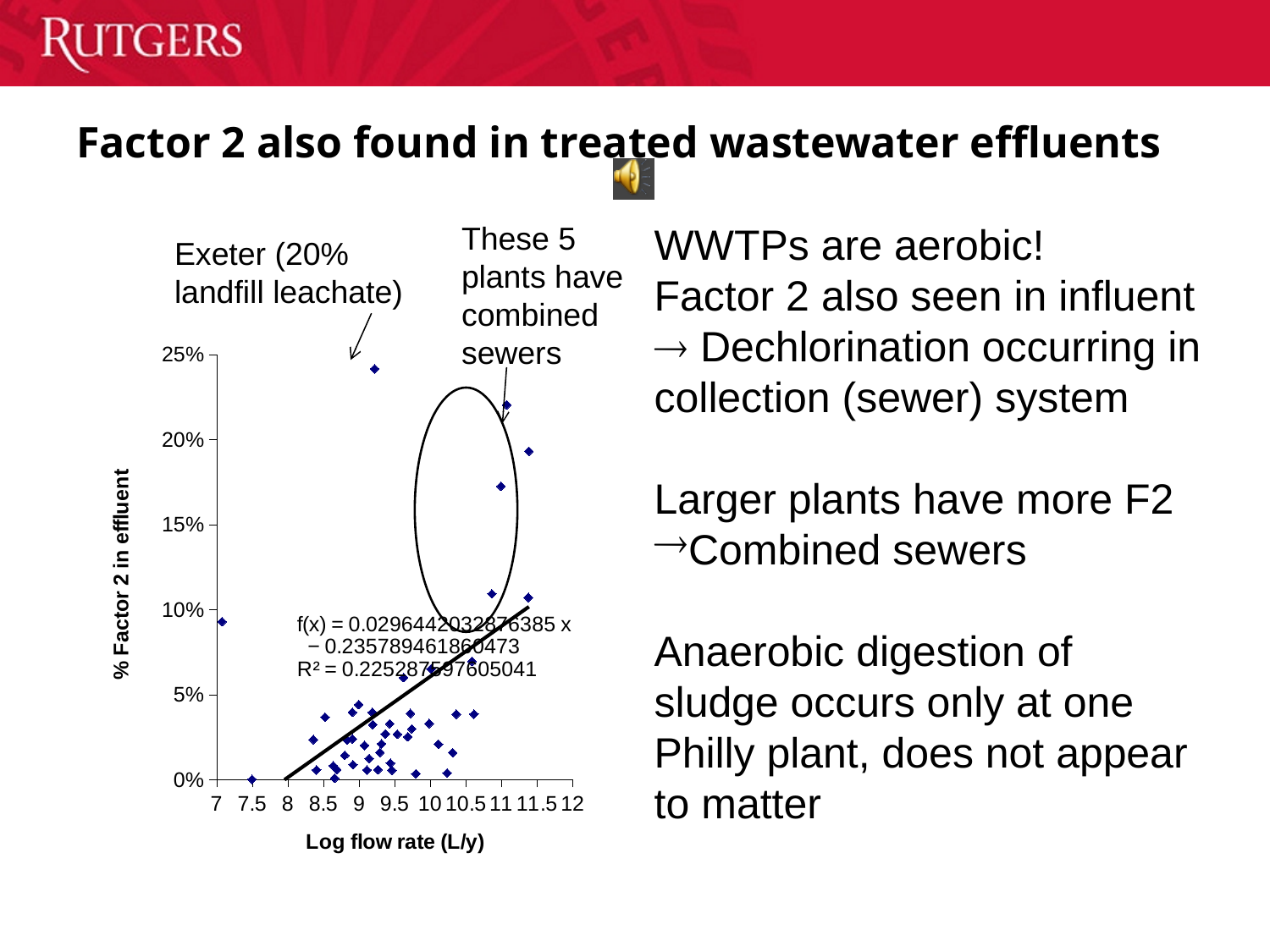
How many plants are circled as having combined sewers? 5 Does the fitted trendline rise or fall as log flow rate increases? rises What is the intercept in the trendline equation printed on the chart? −0.235789461860473 Which plant is labelled as the highest point on the chart? Exeter (20% landfill leachate) What R² value is printed on the chart for the trendline? R² = 0.225287597605041 What kind of chart is shown on the slide? scatter chart What is the title of the x axis of the chart? Log flow rate (L/y) What is the slope coefficient in the trendline equation printed on the chart? 0.0296442032876385 What is the maximum value shown on the y axis? 25% What is the title of the y axis of the chart? % Factor 2 in effluent Is the value for the point at log flow rate 7 greater or less than 10%? less Is the value for the Exeter point (20% landfill leachate) greater or less than 20%? greater